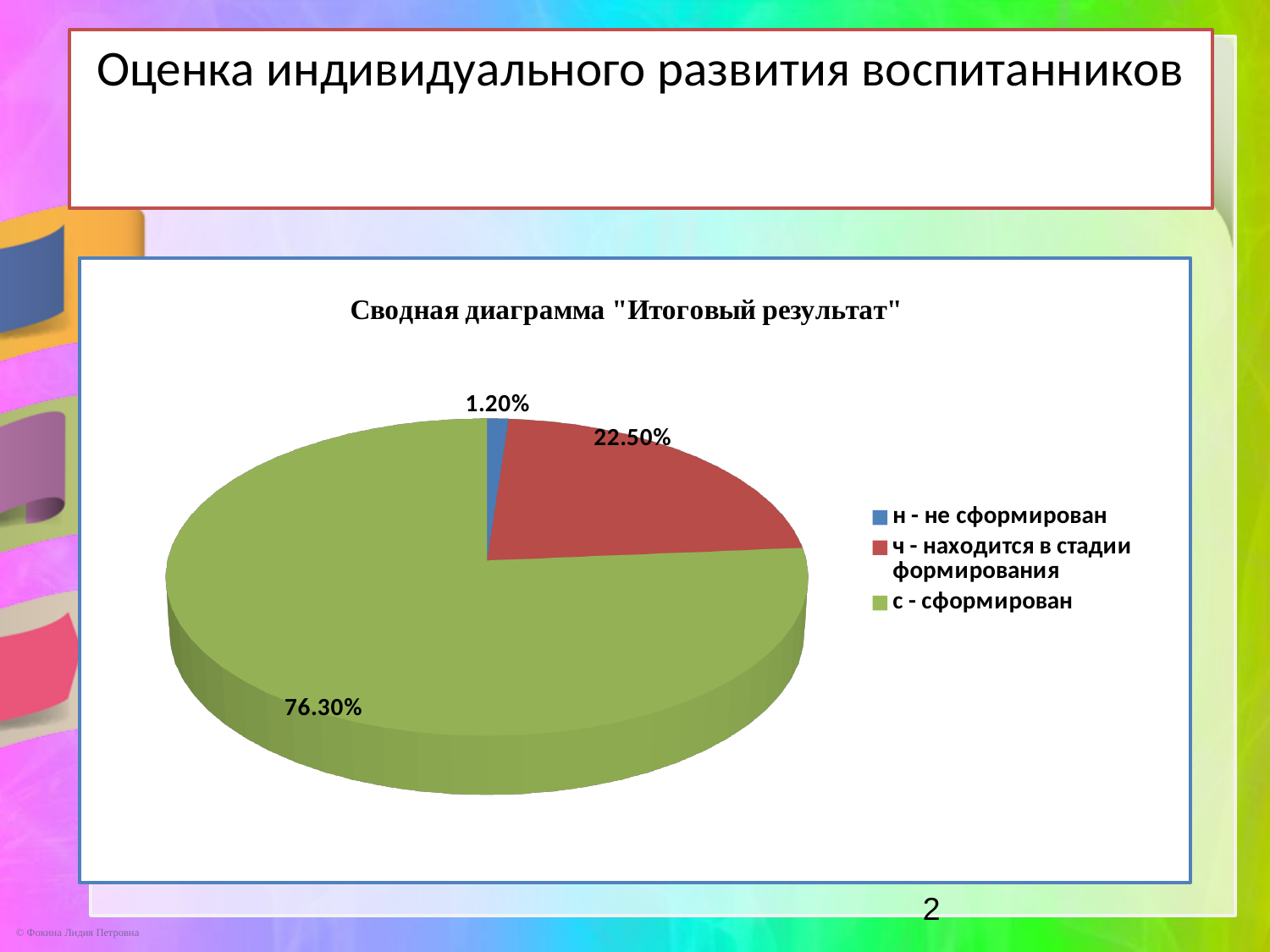
Which is larger: the share for "ч - находится в стадии формирования" or the share for "н - не сформирован"? ч - находится в стадии формирования What is the difference between the shares for "с - сформирован" and "ч - находится в стадии формирования"? 53.80% What colour is the slice for "с - сформирован"? green Which category has the largest slice of the pie? с - сформирован What share of the pie is labelled "с - сформирован"? 76.30% How many entries does the legend list? 3 What is the title of the chart? Сводная диаграмма "Итоговый результат" What share of the pie is labelled "ч - находится в стадии формирования"? 22.50% What share of the pie is labelled "н - не сформирован"? 1.20% What kind of chart is shown on the slide? pie chart How many slices does the pie chart have? 3 Which category has the smallest slice of the pie? н - не сформирован